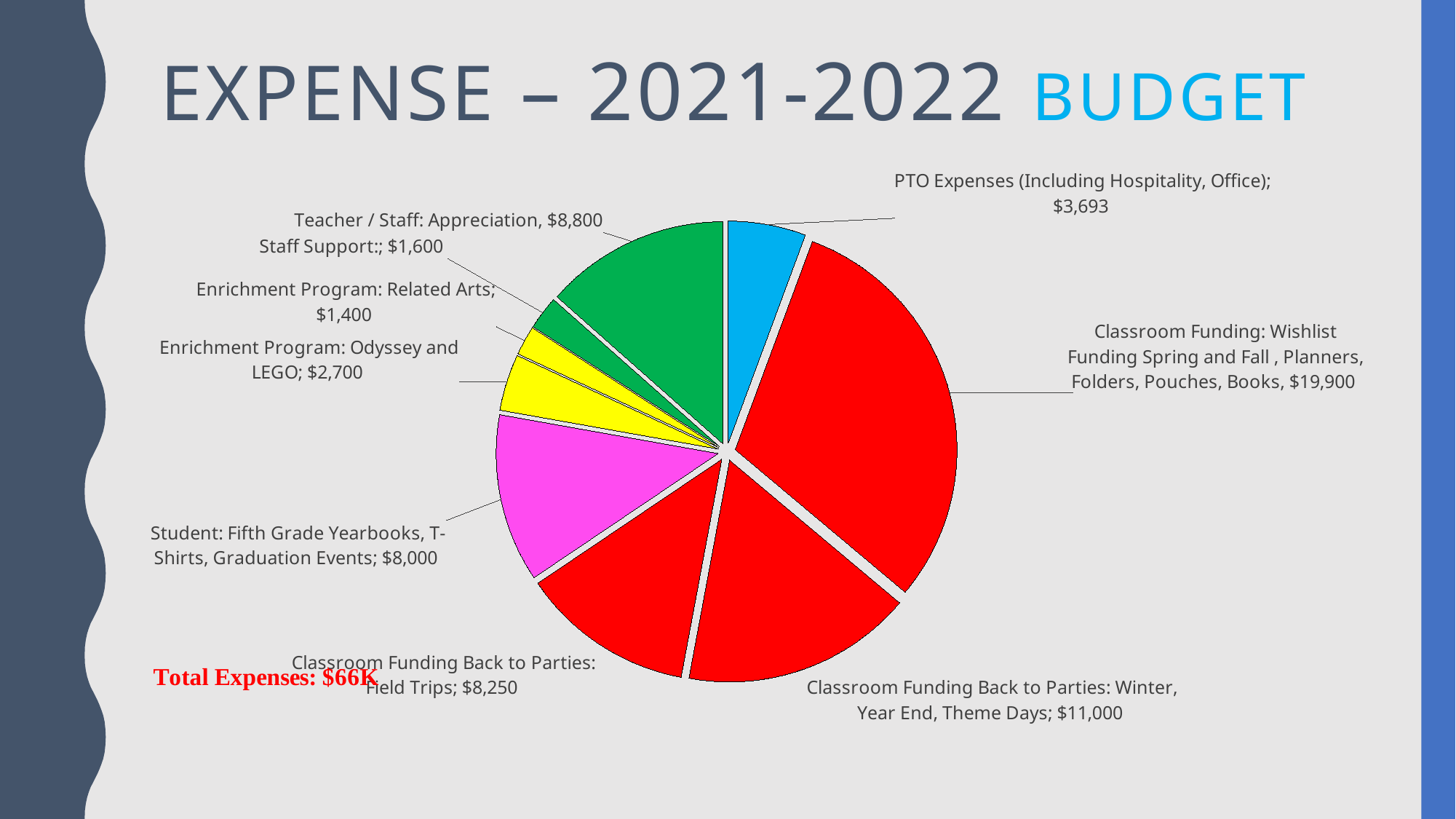
What is the value for PTO Expenses (Including Hospitality, Office)? $3,693 What is the difference between Enrichment Program: Odyssey and LEGO and Enrichment Program: Related Arts? $1,300 What is the value for Teacher / Staff: Appreciation? $8,800 What is the difference between Classroom Funding: Wishlist Funding ($19,900) and Classroom Funding Back to Parties: Winter, Year End, Theme Days ($11,000)? $8,900 Which category has the largest slice of the pie? Classroom Funding: Wishlist Funding Spring and Fall, Planners, Folders, Pouches, Books Which is larger: Classroom Funding Back to Parties: Field Trips or Student: Fifth Grade Yearbooks, T-Shirts, Graduation Events? Classroom Funding Back to Parties: Field Trips What total expenses figure is printed on the slide? $66K What is the value for Classroom Funding: Wishlist Funding Spring and Fall, Planners, Folders, Pouches, Books? $19,900 How many slices does the pie chart have? 9 Which category has the smallest slice of the pie? Enrichment Program: Related Arts What is the value for Classroom Funding Back to Parties: Winter, Year End, Theme Days? $11,000 What kind of chart is shown on the slide? Pie chart